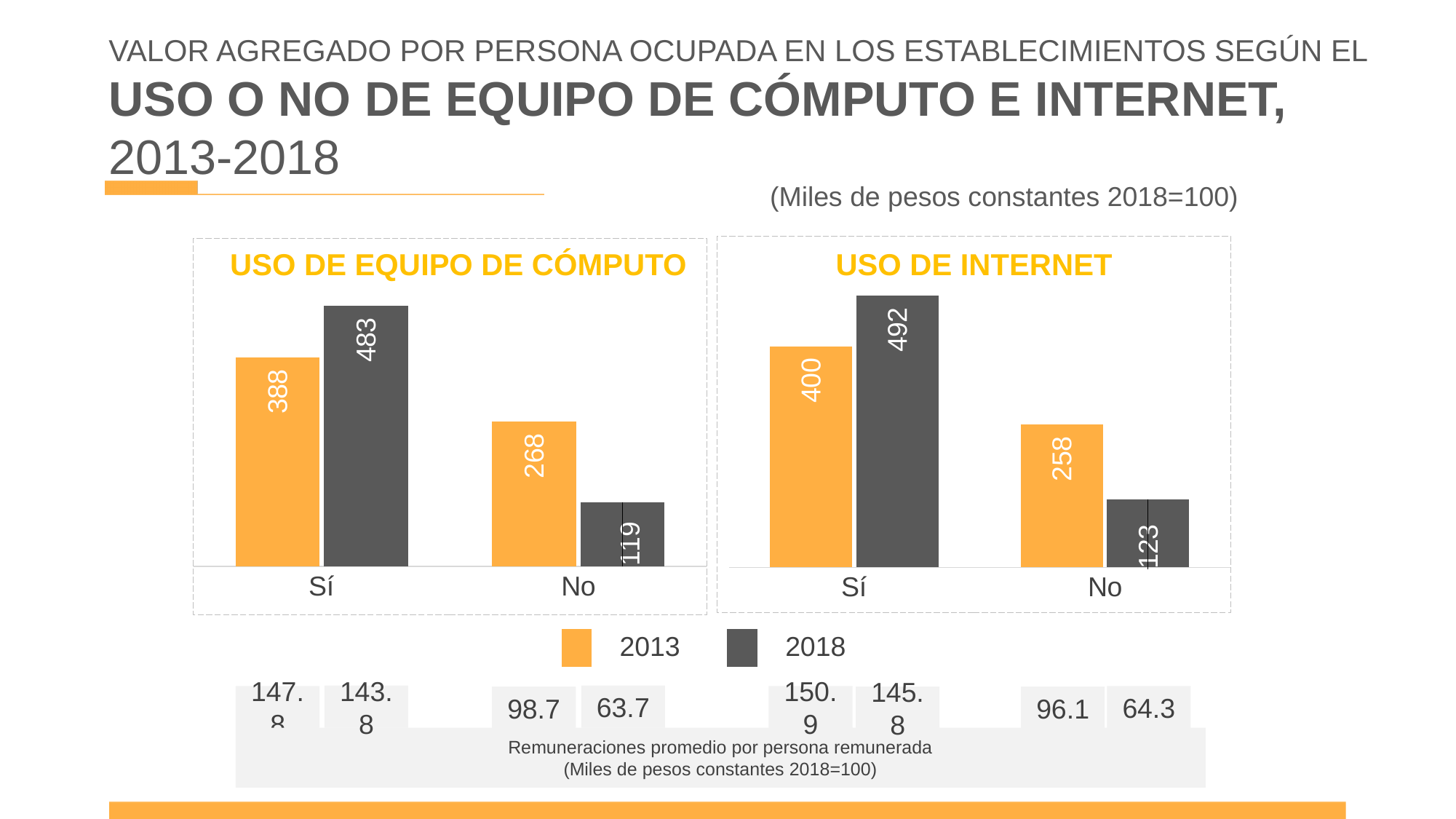
How many series does the legend list for the charts? 2 In the 'USO DE EQUIPO DE CÓMPUTO' chart, what is the value for 'No' in 2018? 119 In the 'USO DE EQUIPO DE CÓMPUTO' chart, which bar is the lowest? No, 2018 In the 'USO DE INTERNET' chart, which is larger for 'No': the 2013 value or the 2018 value? 2013 In the 'USO DE INTERNET' chart, what is the difference between the 2018 and 2013 values for 'Sí'? 92 Which colour represents the year 2013 in the legend? Orange How many categories are shown on the x axis of the 'USO DE EQUIPO DE CÓMPUTO' chart? 2 In the 'USO DE EQUIPO DE CÓMPUTO' chart, what is the value for 'Sí' in 2018? 483 In the 'USO DE INTERNET' chart, which bar is the highest? Sí, 2018 What type of chart is the 'USO DE INTERNET' chart? Bar chart In the 'USO DE INTERNET' chart, what is the value for 'No' in 2013? 258 In the 'USO DE EQUIPO DE CÓMPUTO' chart, what is the difference between the 2013 and 2018 values for 'No'? 149